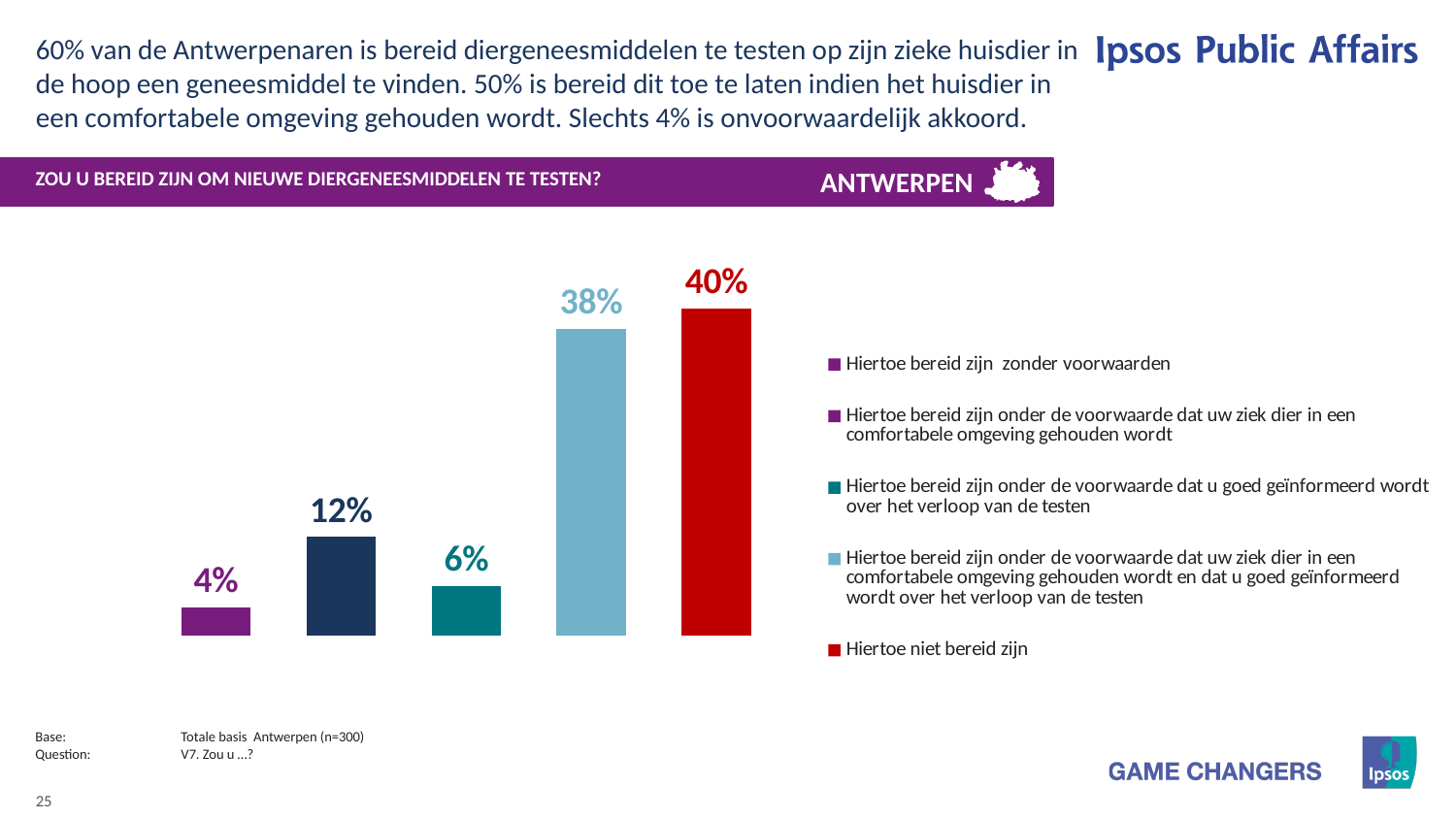
Which category has the highest value in the chart? Hiertoe niet bereid zijn What is the difference between the value for "Hiertoe niet bereid zijn" and the value for "Hiertoe bereid zijn zonder voorwaarden"? 36% What percentage of respondents are willing to test new veterinary medicines without conditions ("Hiertoe bereid zijn zonder voorwaarden")? 4% What colour is the bar for "Hiertoe niet bereid zijn"? Red Which is larger: the value for the light blue bar (comfortable environment and well informed) or the value for the dark blue bar (comfortable environment only)? The light blue bar (38%) What percentage of respondents are not willing to test new veterinary medicines ("Hiertoe niet bereid zijn")? 40% What is the value for the category "Hiertoe bereid zijn onder de voorwaarde dat u goed geïnformeerd wordt over het verloop van de testen"? 6% What type of chart is shown on the slide? Bar chart Which category has the lowest value in the chart? Hiertoe bereid zijn zonder voorwaarden How many bars are shown in the chart? 5 What is the value for the category "Hiertoe bereid zijn onder de voorwaarde dat uw ziek dier in een comfortabele omgeving gehouden wordt"? 12% How many entries does the legend list? 5